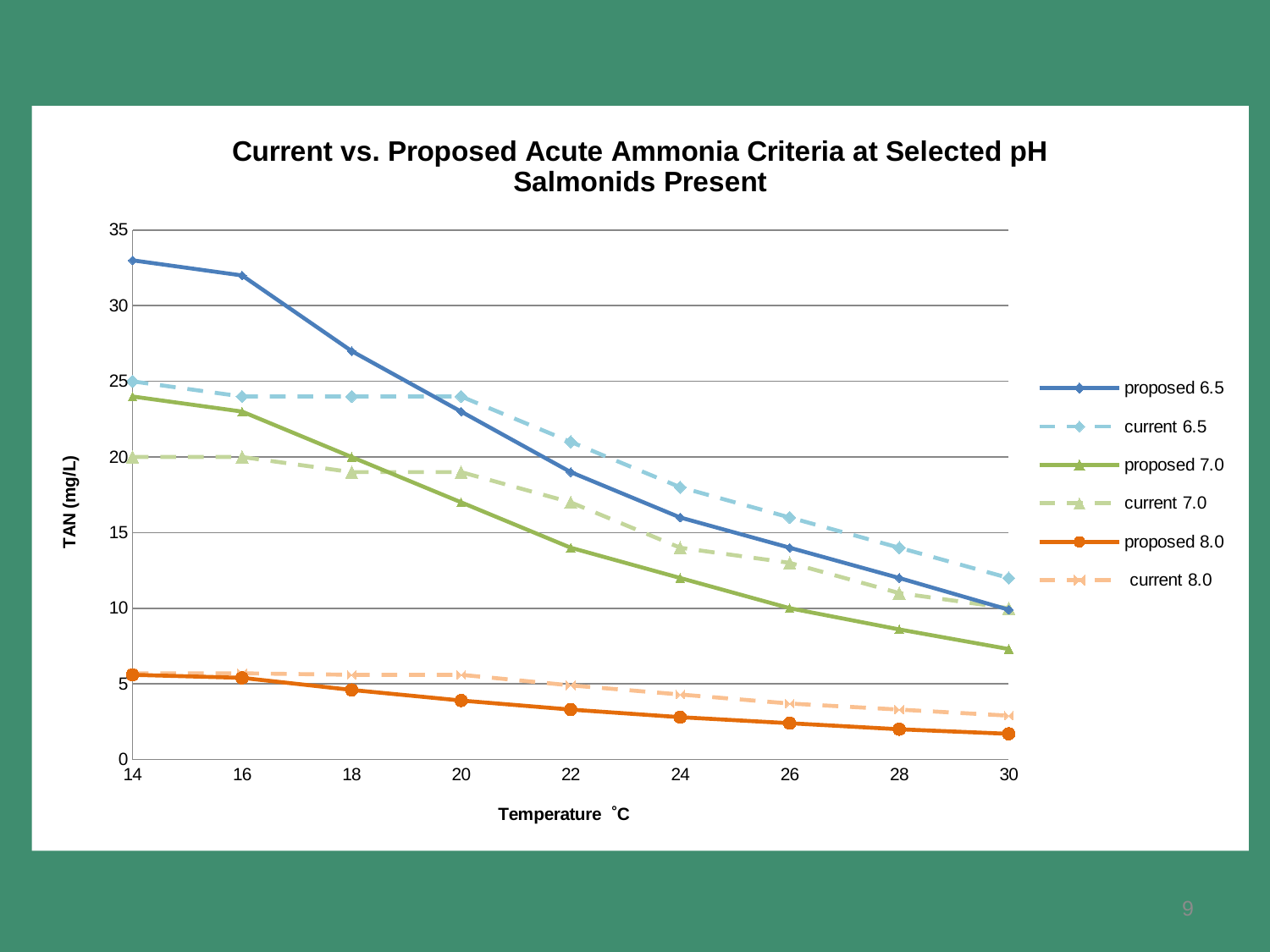
Which series is drawn with a solid orange line with circle markers? proposed 8.0 How many series does the legend list? 6 Is the value for proposed 6.5 at 14 °C greater or less than 30? greater Which series has the highest value at 14 °C? proposed 6.5 Is the value for current 6.5 at 22 °C greater or less than 20? greater How many temperature points are plotted along the x axis? 9 What is the label of the y axis? TAN (mg/L) Which series has the lowest value at 30 °C? proposed 8.0 Do the values for the proposed 6.5 series rise or fall as temperature increases? fall Is the value for proposed 8.0 at 30 °C greater or less than 5? less What kind of chart is shown on the slide? line chart At 26 °C, which is larger: current 6.5 or proposed 7.0? current 6.5